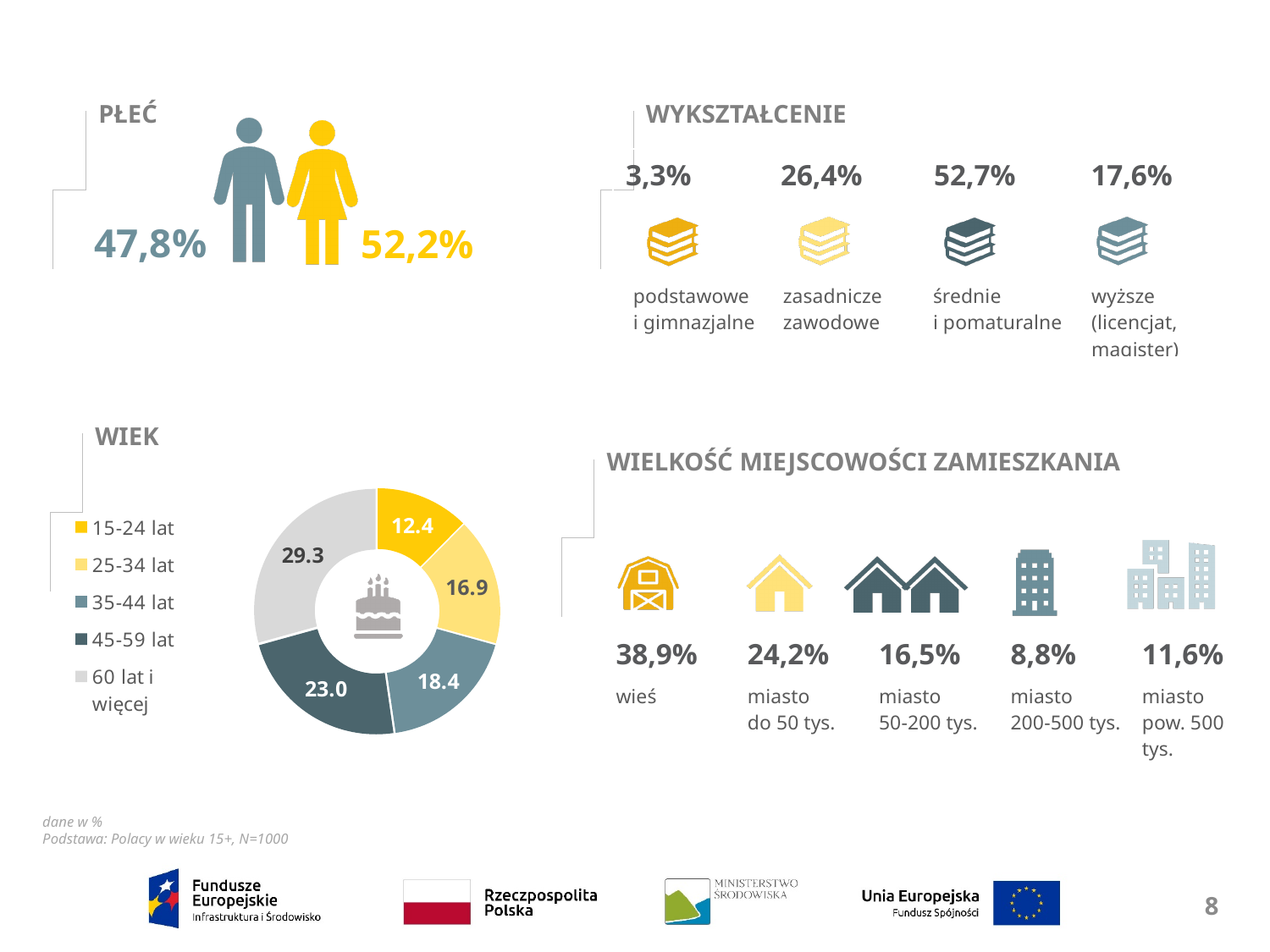
In the WIEK chart, which age group has the largest segment? 60 lat i więcej In the WIEK chart, what is the difference between the 45-59 lat segment and the 35-44 lat segment? 4.6 In the WIEK chart, what share of the whole does the 60 lat i więcej segment represent? 29.3 In the WIEK chart, what is the value for the 15-24 lat segment? 12.4 How many age groups are shown in the WIEK chart? 5 In the WIEK chart, which is larger: the 25-34 lat segment or the 35-44 lat segment? 35-44 lat What type of chart is the WIEK chart? Donut (pie) chart What is the title of the chart with the age groups? WIEK In the WIEK chart, what is the difference between the 60 lat i więcej segment and the 15-24 lat segment? 16.9 In the WIEK chart, what is the value for the 45-59 lat segment? 23.0 In the WIEK chart, which age group has the smallest segment? 15-24 lat In the WIEK chart, what is the value for the 35-44 lat segment? 18.4